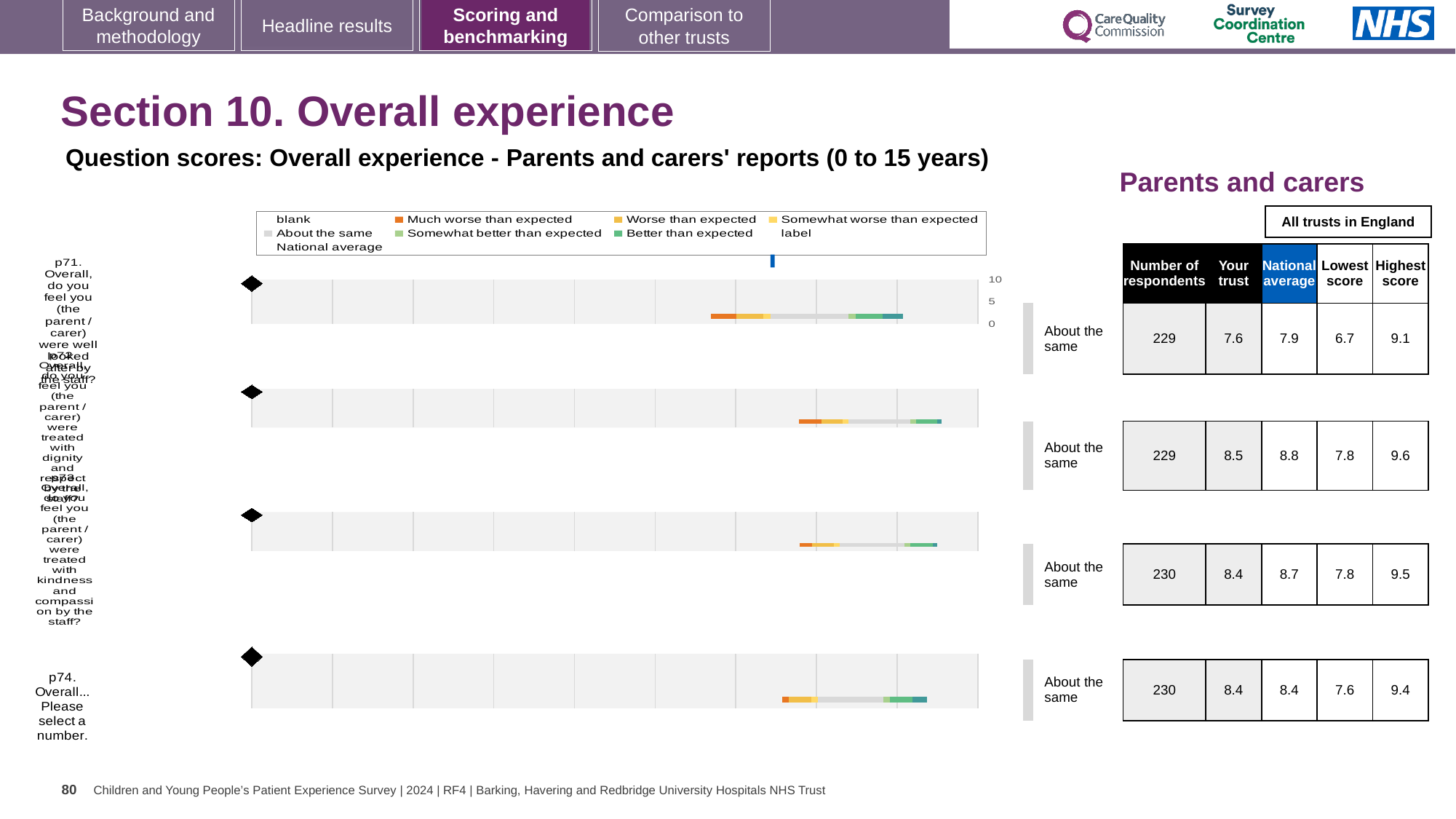
How many question rows (bars) are plotted in the chart? 4 What kind of chart is used to show the question scores on this slide? bar chart For p71, how much higher is the national average than the 'Your trust' score in the table beside the chart? 0.3 According to the table beside the chart, what is the 'Your trust' score for p74 (Overall... Please select a number)? 8.4 For p72, which is larger in the table beside the chart: the 'Your trust' score or the national average? National average According to the table beside the chart, how many respondents answered p71? 229 What is the highest tick value shown on the chart's score axis? 10 Which question row has the highest 'Your trust' score in the table beside the chart? p72 In the legend, what colour represents 'Much worse than expected'? orange According to the table beside the chart, what is the lowest score for p74? 7.6 According to the table beside the chart, what is the national average for p72? 8.8 According to the table beside the chart, what is the highest score for p73? 9.5